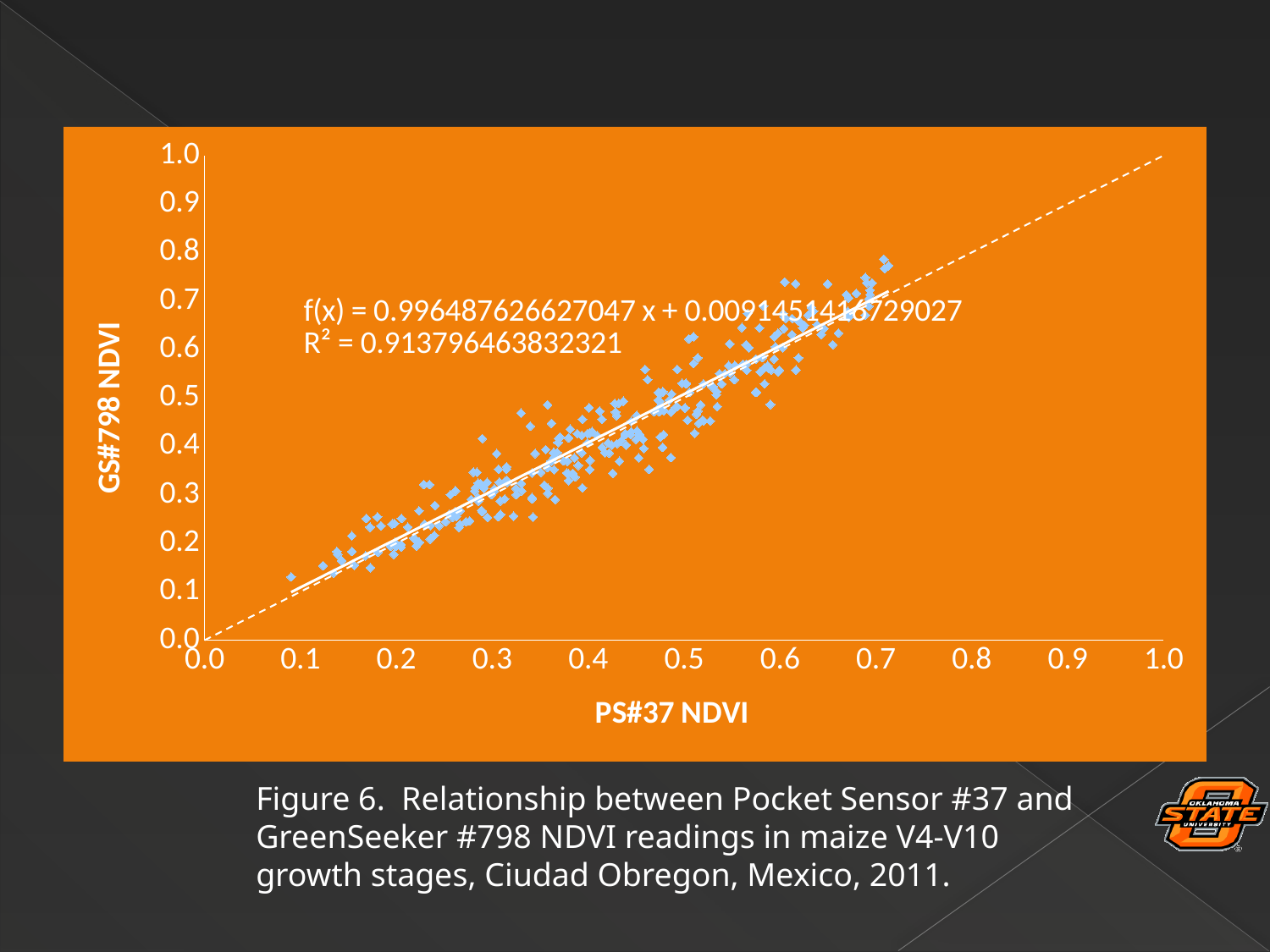
What is the maximum value shown on the x axis? 1.0 What kind of chart is shown on the slide? scatter plot What is the label of the x axis? PS#37 NDVI What is the slope coefficient of x in the fitted equation printed on the chart? 0.996487626627047 As PS#37 NDVI increases along the x axis, do the GS#798 NDVI values generally rise or fall? rise Is the GS#798 NDVI value of the highest plotted point greater or less than 0.7? greater Is the R² value printed on the chart greater or less than 0.9? greater Is the PS#37 NDVI value of the rightmost plotted point greater or less than 0.8? less What is the label of the y axis? GS#798 NDVI What is the R² value printed on the chart? 0.913796463832321